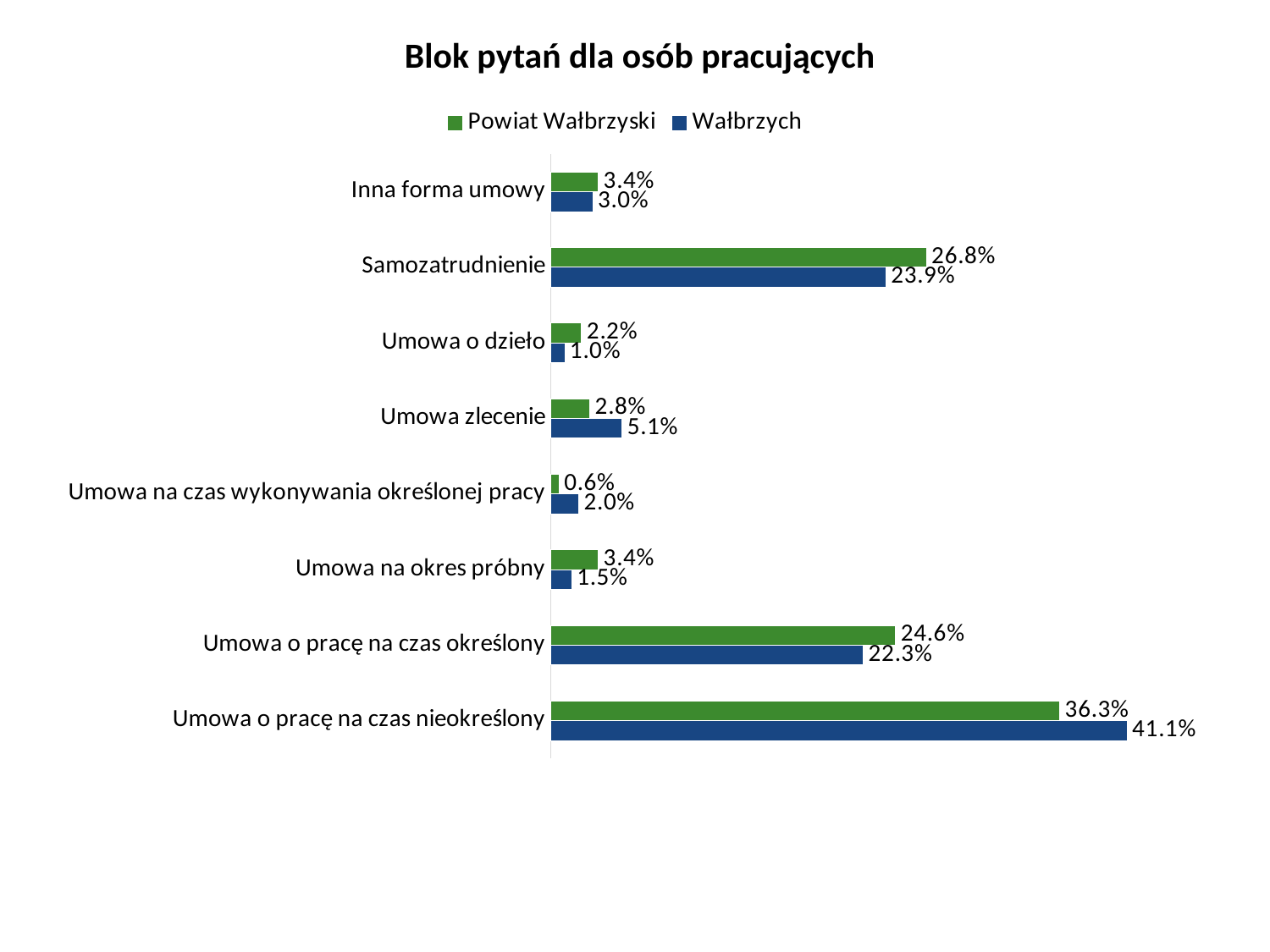
What is the value for Wałbrzych for Umowa zlecenie? 5.1% What is the value for Wałbrzych for Umowa o pracę na czas nieokreślony? 41.1% What is the difference between the Wałbrzych and Powiat Wałbrzyski values for Umowa o pracę na czas nieokreślony? 4.8% What is the title of the chart? Blok pytań dla osób pracujących What is the difference between the Powiat Wałbrzyski and Wałbrzych values for Umowa o pracę na czas określony? 2.3% What kind of chart is shown on the slide? Bar chart How many categories are shown on the chart? 8 Which category has the lowest value for Wałbrzych? Umowa o dzieło How many series does the legend list? 2 What is the value for Powiat Wałbrzyski for Samozatrudnienie? 26.8% Which category has the highest value for Powiat Wałbrzyski? Umowa o pracę na czas nieokreślony For Umowa na okres próbny, which series has the larger value, Powiat Wałbrzyski or Wałbrzych? Powiat Wałbrzyski